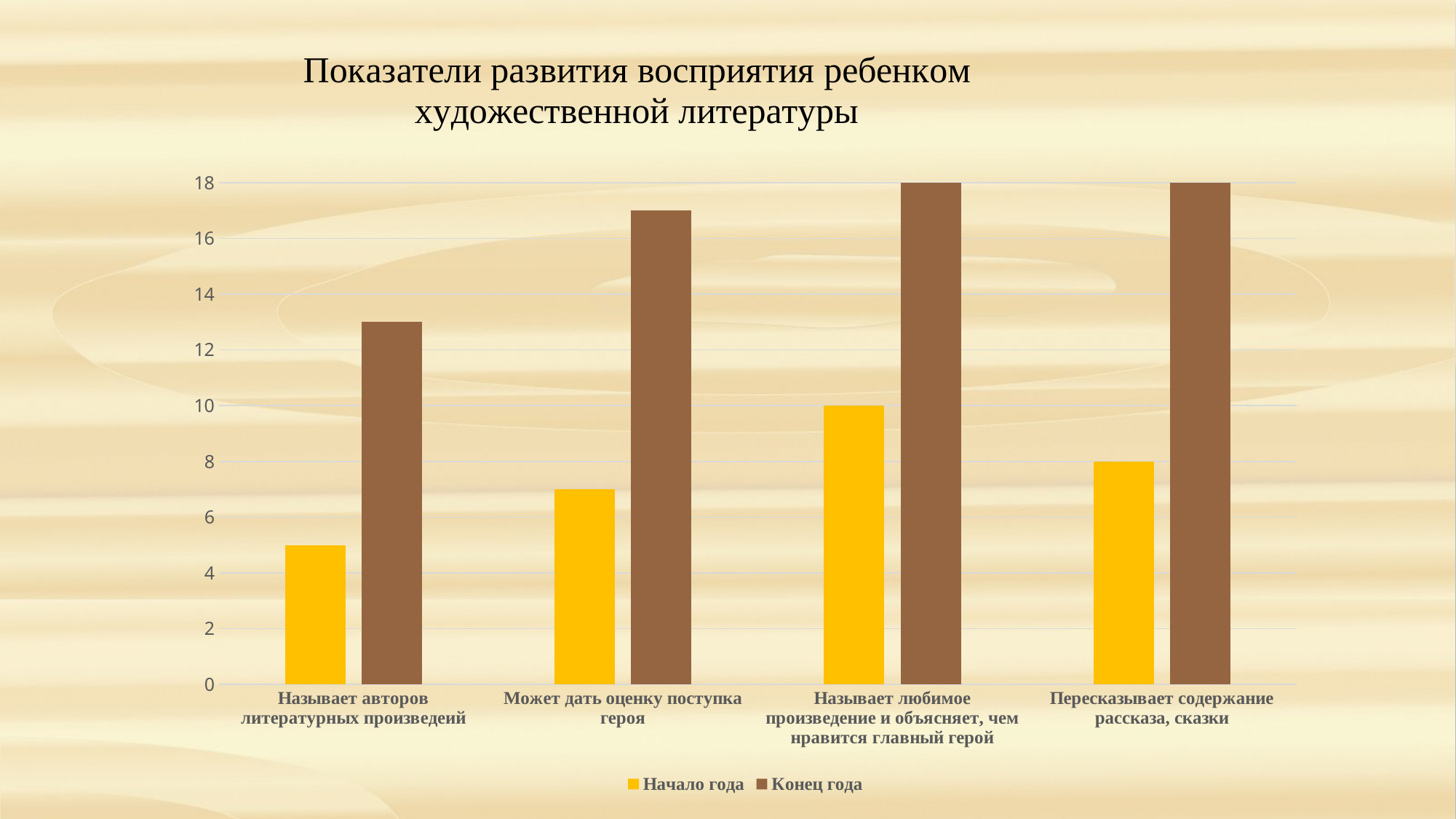
Which is larger for 'Может дать оценку поступка героя': Начало года or Конец года? Конец года Which category has the highest Начало года value? Называет любимое произведение и объясняет, чем нравится главный герой What is the value of Начало года for 'Пересказывает содержание рассказа, сказки'? 8 Which category has the lowest Конец года value? Называет авторов литературных произведений What is the difference between Конец года and Начало года for 'Пересказывает содержание рассказа, сказки'? 10 How many series does the legend list? 2 Is the value of Начало года for 'Называет авторов литературных произведений' greater or less than 6? less What is the value of Конец года for 'Пересказывает содержание рассказа, сказки'? 18 What is the value of Начало года for 'Называет любимое произведение и объясняет, чем нравится главный герой'? 10 What kind of chart is shown on the slide? bar chart Is the value of Конец года for 'Может дать оценку поступка героя' greater or less than 16? greater How many categories are shown on the x axis? 4